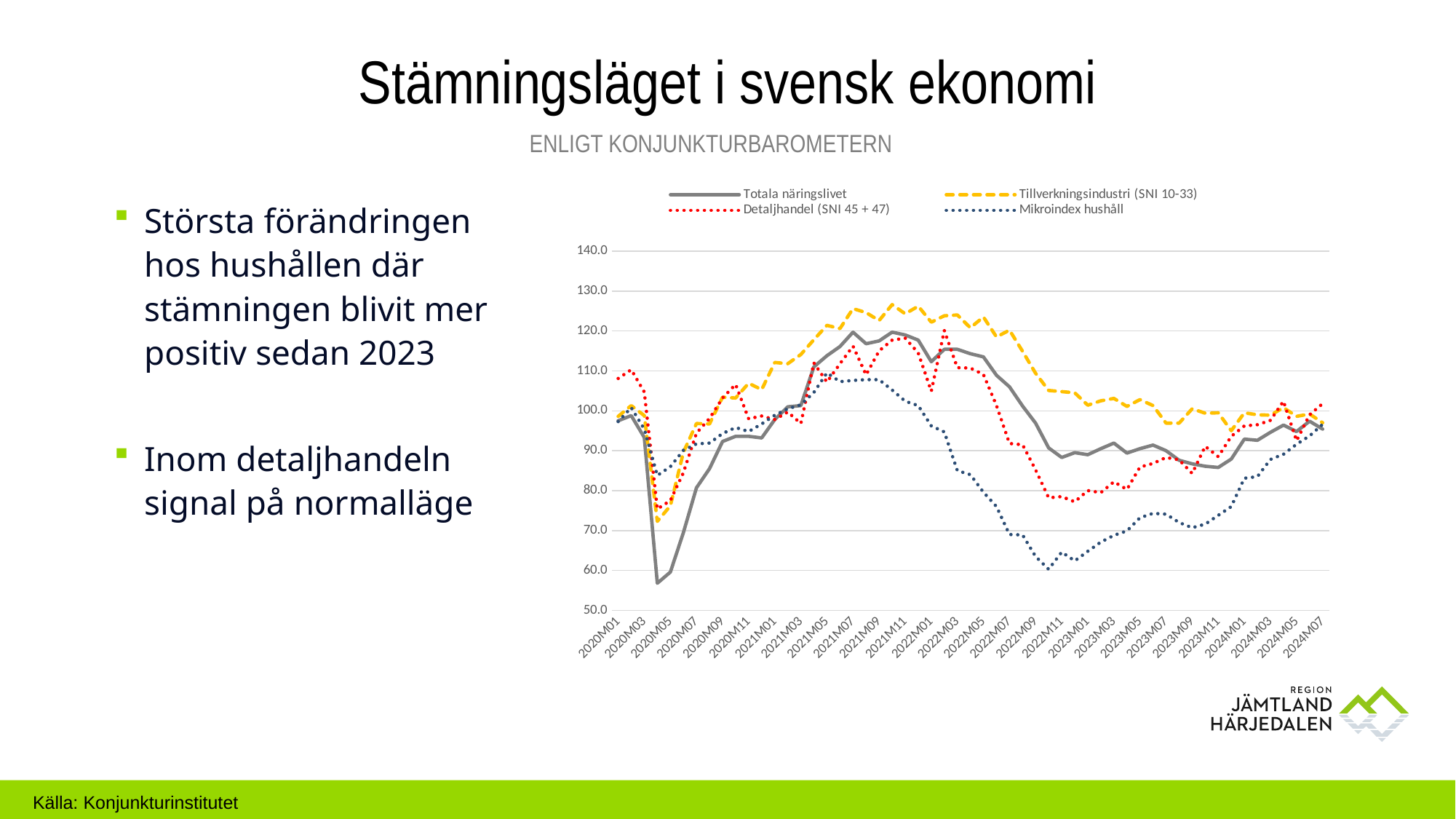
Which series is drawn as a dashed yellow line? Tillverkningsindustri (SNI 10-33) Is the value for Tillverkningsindustri (SNI 10-33) at 2021M11 greater or less than 120? greater Is the value for Mikroindex hushåll at 2022M11 greater or less than 70? less At 2022M11, which series is higher: Tillverkningsindustri (SNI 10-33) or Mikroindex hushåll? Tillverkningsindustri (SNI 10-33) Does the Mikroindex hushåll series rise or fall from 2022M11 to 2024M07? rise How many series does the chart legend list? 4 Which series has the highest value around 2021M11? Tillverkningsindustri (SNI 10-33) Which series drops to the lowest value in 2020? Totala näringslivet What is the subtitle shown below the slide title? ENLIGT KONJUNKTURBAROMETERN What kind of chart is shown on the slide? line chart